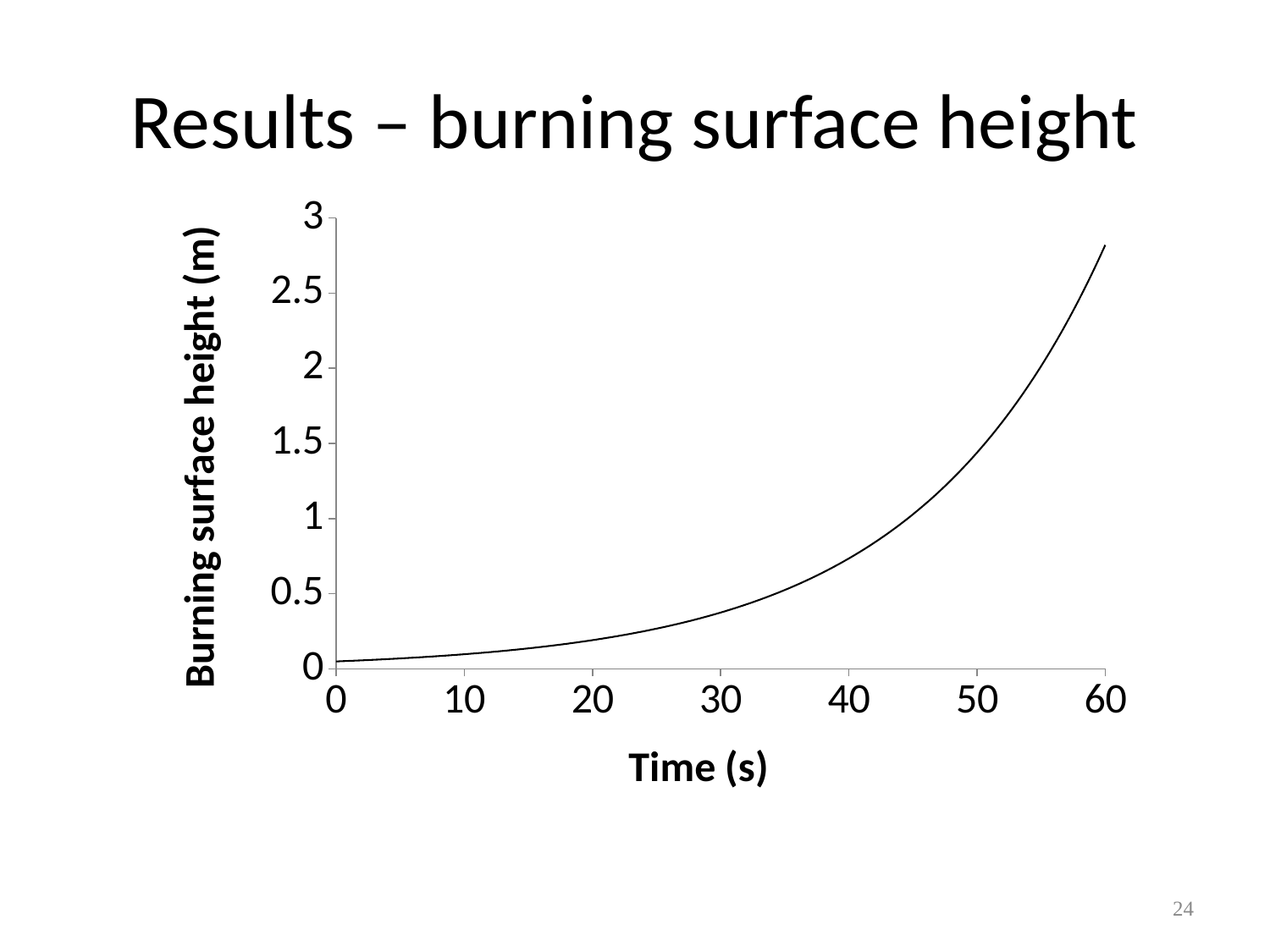
Does the burning surface height rise or fall as time increases along the x axis? rise At which time on the x axis is the burning surface height lowest? 0 Is the burning surface height at 30 s greater or less than 0.5? less What kind of chart is shown on the slide? line chart Is the burning surface height at 20 s greater or less than 0.5? less At which time on the x axis is the burning surface height highest? 60 Is the burning surface height at 40 s greater or less than 1? less What is the title of the x axis? Time (s) What is the title of the y axis? Burning surface height (m) Which is larger, the burning surface height at 50 s or at 30 s? 50 s